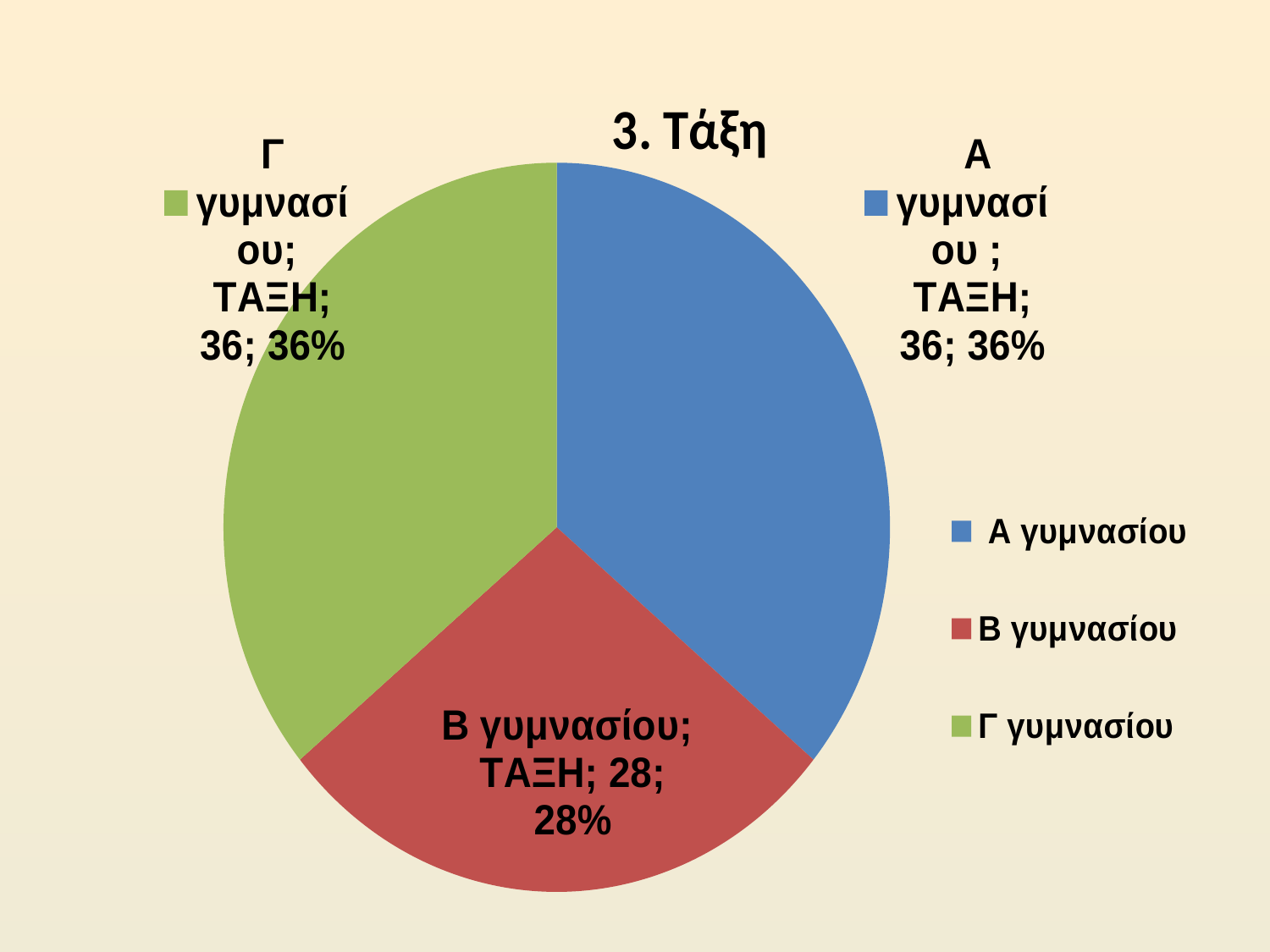
What type of chart is shown on the slide? pie chart What share of the pie does Α γυμνασίου represent? 36% What is the title of the chart? 3. Τάξη What share of the pie does Β γυμνασίου represent? 28% What is the value for Γ γυμνασίου? 36 What is the difference between the values for Γ γυμνασίου and Β γυμνασίου? 8 Which colour represents Γ γυμνασίου in the legend? green How many slices does the pie chart have? 3 Which category has the smallest slice? Β γυμνασίου What is the value for Α γυμνασίου? 36 What is the value for Β γυμνασίου? 28 Which is larger, Α γυμνασίου or Β γυμνασίου? Α γυμνασίου